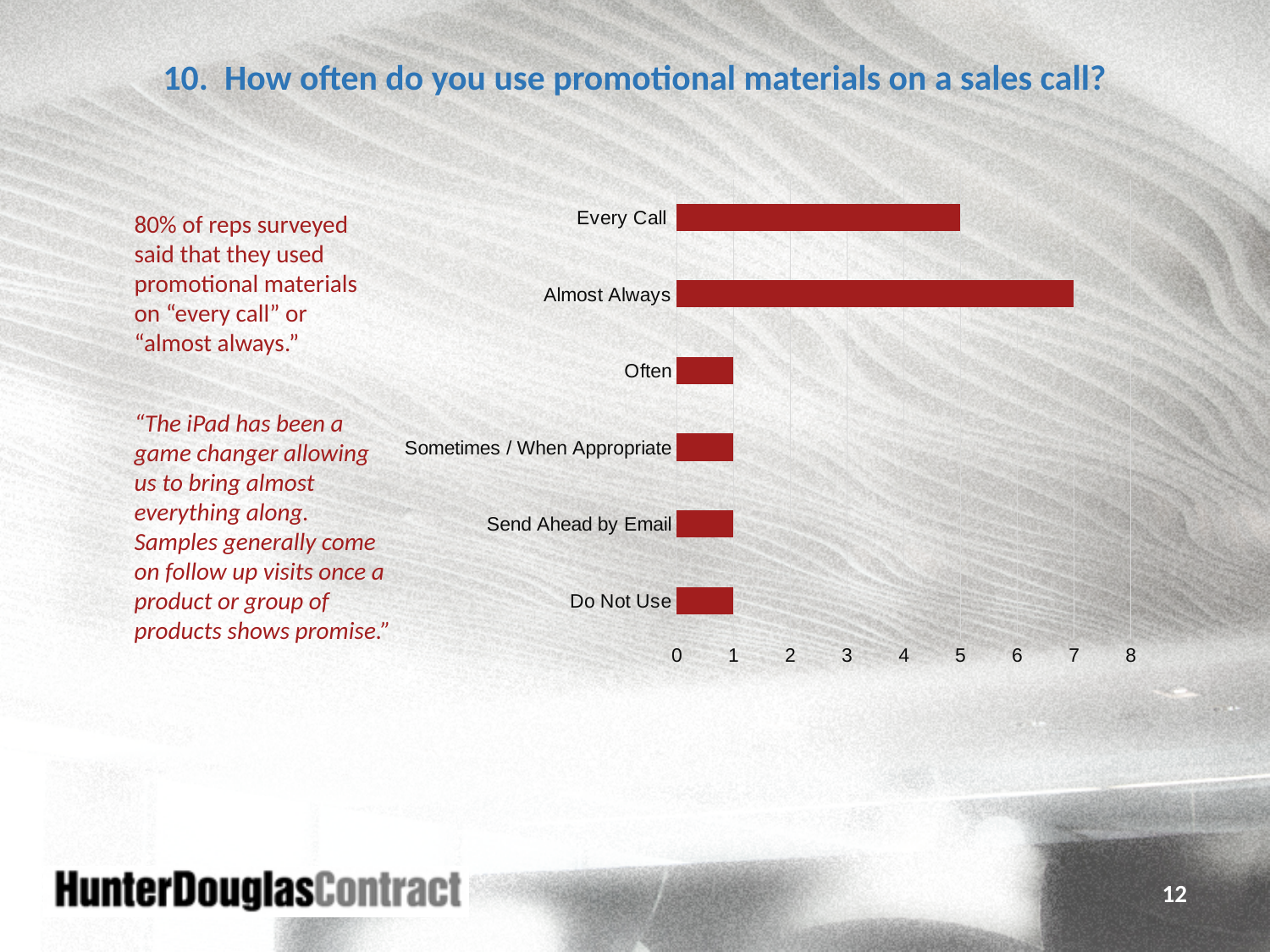
What kind of chart is shown on the slide? bar chart Is the value for Almost Always greater or less than 6? greater Is the value for Send Ahead by Email greater or less than 2? less What colour are the bars in the chart? red What is the difference between the values for Almost Always and Every Call? 2 What is the highest value shown on the x axis? 8 How many categories does the chart show? 6 Which is larger, the value for Every Call or the value for Often? Every Call What is the value for Almost Always? 7 Which category has the highest value? Almost Always What is the value for Do Not Use? 1 What is the value for Every Call? 5